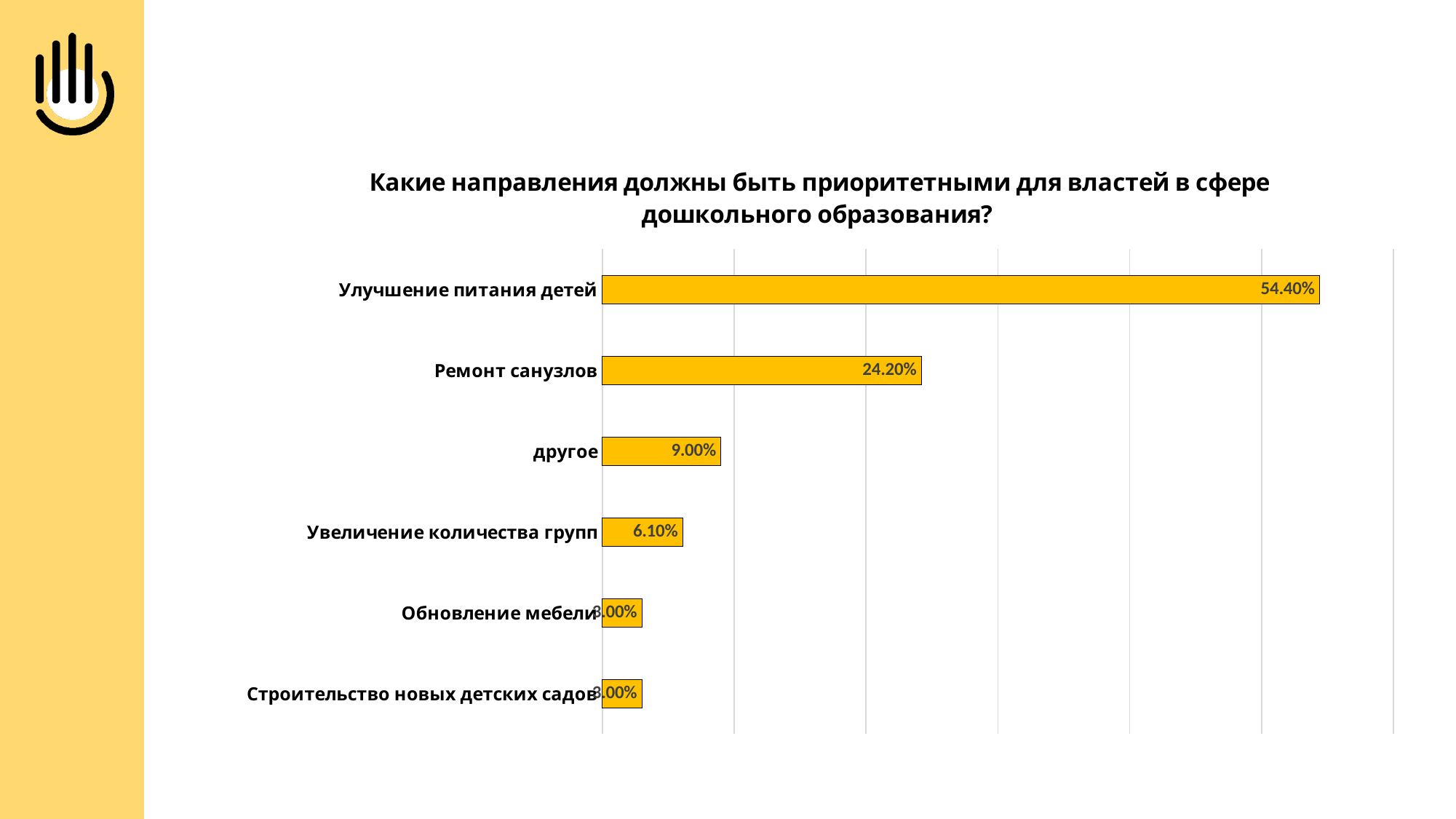
What kind of chart is shown on the slide? Bar chart What is the title of the chart? Какие направления должны быть приоритетными для властей в сфере дошкольного образования? Which is larger, the value for Увеличение количества групп or the value for Обновление мебели? Увеличение количества групп Which category has the highest value? Улучшение питания детей What is the value for другое? 9.00% What is the value for Увеличение количества групп? 6.10% What is the value for Ремонт санузлов? 24.20% How many categories are shown in the chart? 6 Which is larger, the value for Ремонт санузлов or the value for другое? Ремонт санузлов What is the difference between the values for другое and Увеличение количества групп? 2.90% What is the value for Улучшение питания детей? 54.40% What is the difference between the values for Улучшение питания детей and Ремонт санузлов? 30.20%